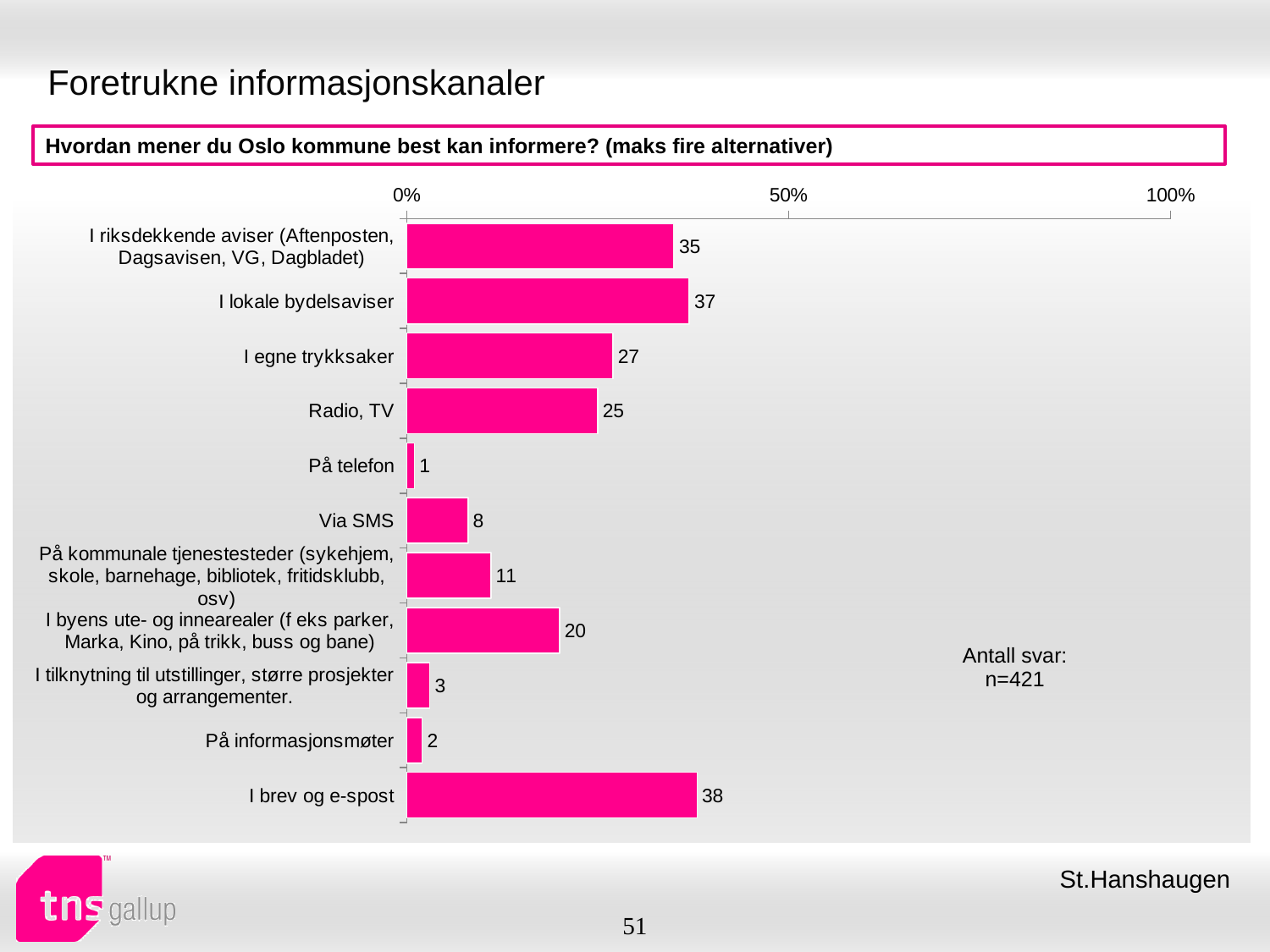
What is the number of responses (Antall svar) shown on the slide? n=421 What is the value for "På informasjonsmøter"? 2 Is the value for "I brev og e-spost" greater or less than 50%? less How many categories are shown in the chart? 11 Which category has the highest value? I brev og e-spost What kind of chart is shown on the slide? bar chart Which category has the lowest value? På telefon What is the value for "Radio, TV"? 25 What is the value for "Via SMS"? 8 What is the value for "I lokale bydelsaviser"? 37 What is the difference between the values for "I brev og e-spost" and "I egne trykksaker"? 11 Which is larger, the value for "I riksdekkende aviser (Aftenposten, Dagsavisen, VG, Dagbladet)" or the value for "I lokale bydelsaviser"? I lokale bydelsaviser